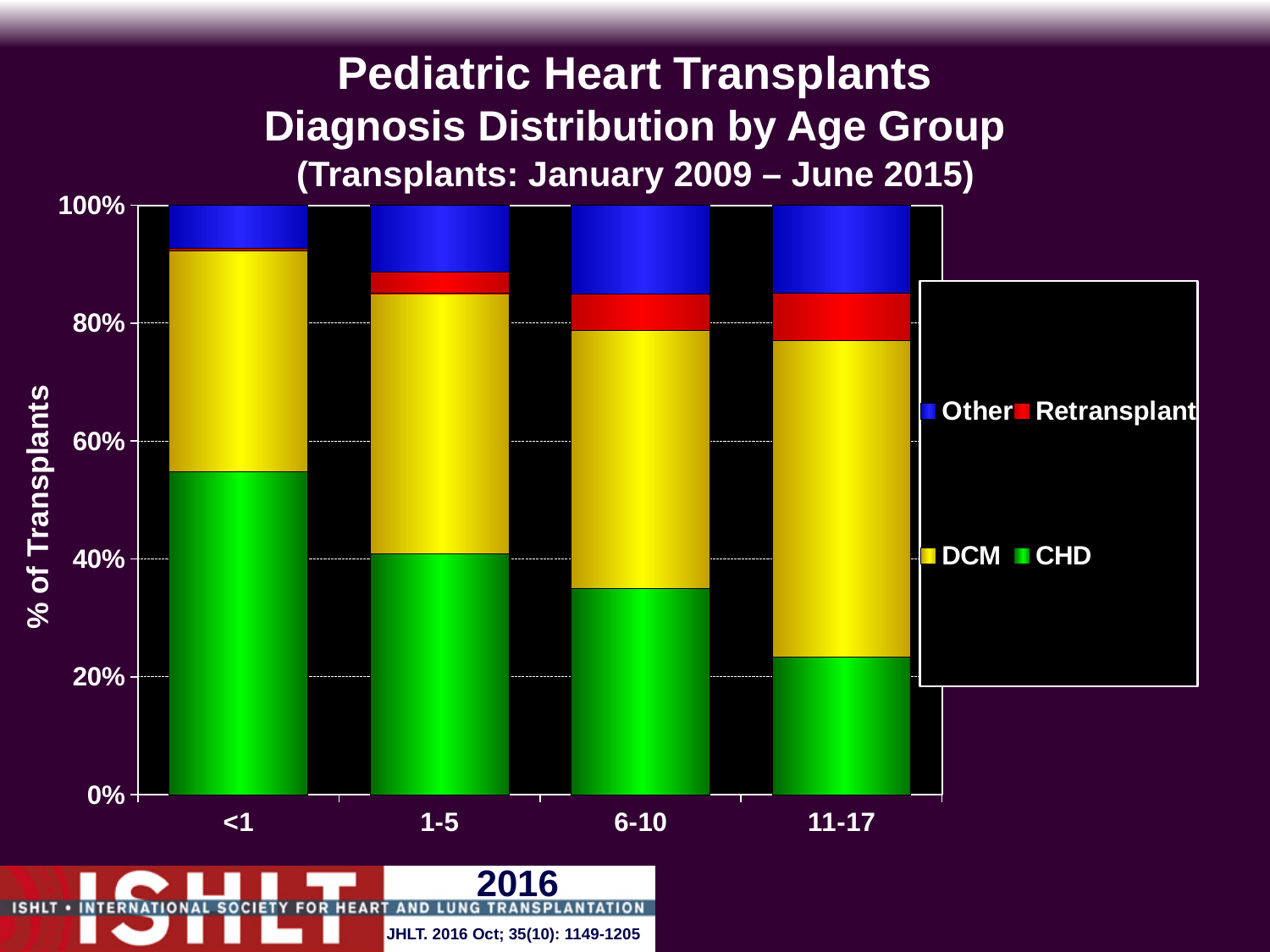
How many age groups are shown on the x axis? 4 Which is larger, the CHD share for the 1-5 age group or for the 11-17 age group? 1-5 Does the CHD share rise or fall as age group increases from <1 to 11-17? Fall Is the CHD share for the 6-10 age group greater or less than 40%? less Which age group has the smallest CHD share? 11-17 What is the label on the y axis? % of Transplants Is the CHD share for the 11-17 age group greater or less than 40%? less Which age group has the smallest Retransplant share? <1 What kind of chart is shown on the slide? Stacked bar chart Which age group has the largest CHD share? <1 Is the CHD share for the <1 age group greater or less than 40%? greater How many series does the legend list? 4